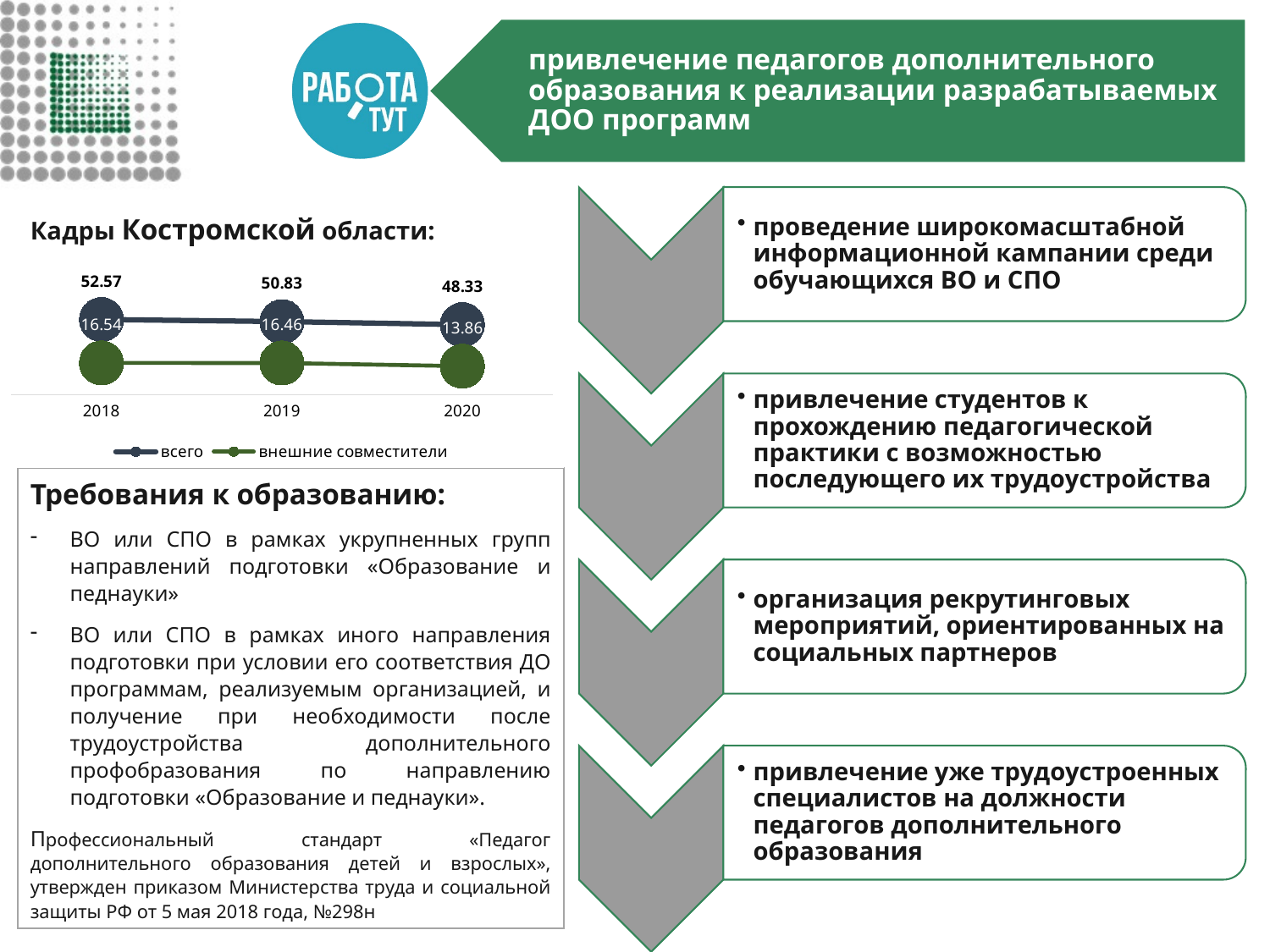
What is the value for "внешние совместители" in 2019? 16.46 What kind of chart is shown under "Кадры Костромской области"? line chart What is the value for "всего" in 2018? 52.57 Do the values for "всего" rise or fall from 2018 to 2020? fall Which is larger: the "всего" value in 2019 or in 2020? 2019 What is the difference between the "всего" values for 2018 and 2020? 4.24 What is the value for "всего" in 2020? 48.33 What is the value for "внешние совместители" in 2020? 13.86 How many series does the chart legend list? 2 In which year is the value for "внешние совместители" lowest? 2020 How many years are shown on the x axis of the chart? 3 In which year is the value for "всего" highest? 2018